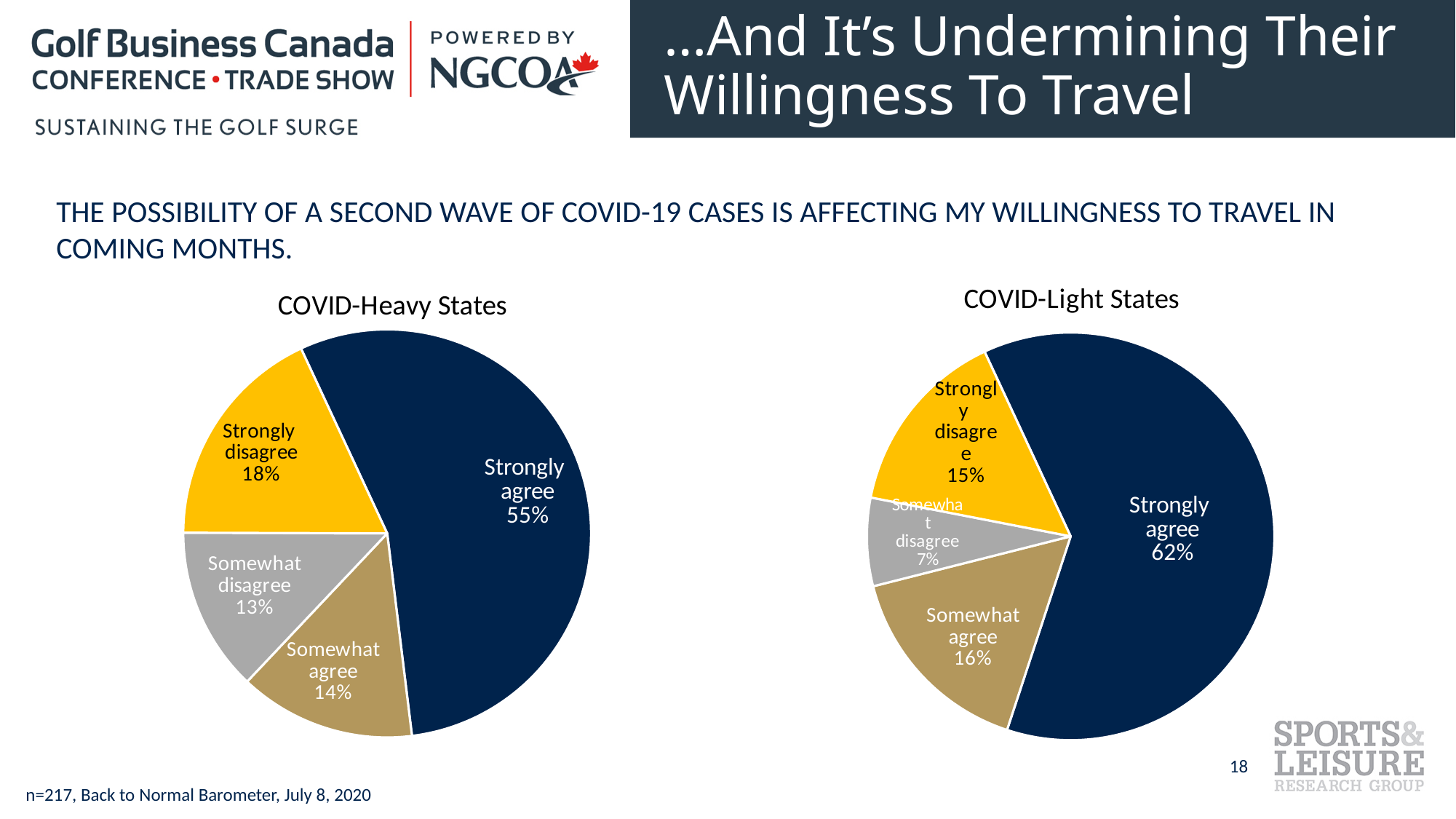
In the COVID-Heavy States chart, what share of respondents strongly agree? 55% In the COVID-Light States chart, what share of respondents strongly agree? 62% In the COVID-Heavy States chart, what percentage strongly disagree? 18% In the COVID-Heavy States chart, which response has the largest slice? Strongly agree In the COVID-Light States chart, what percentage somewhat agree? 16% What is the difference between the Strongly agree shares in the COVID-Light States chart and the COVID-Heavy States chart? 7 percentage points How many slices does the COVID-Light States pie chart have? 4 In the COVID-Light States chart, which response has the smallest slice? Somewhat disagree In the COVID-Heavy States chart, which response has the smallest slice? Somewhat disagree What type of chart is used for COVID-Heavy States? Pie chart In the COVID-Light States chart, what percentage somewhat disagree? 7% Which chart has the larger Strongly disagree share, COVID-Heavy States or COVID-Light States? COVID-Heavy States